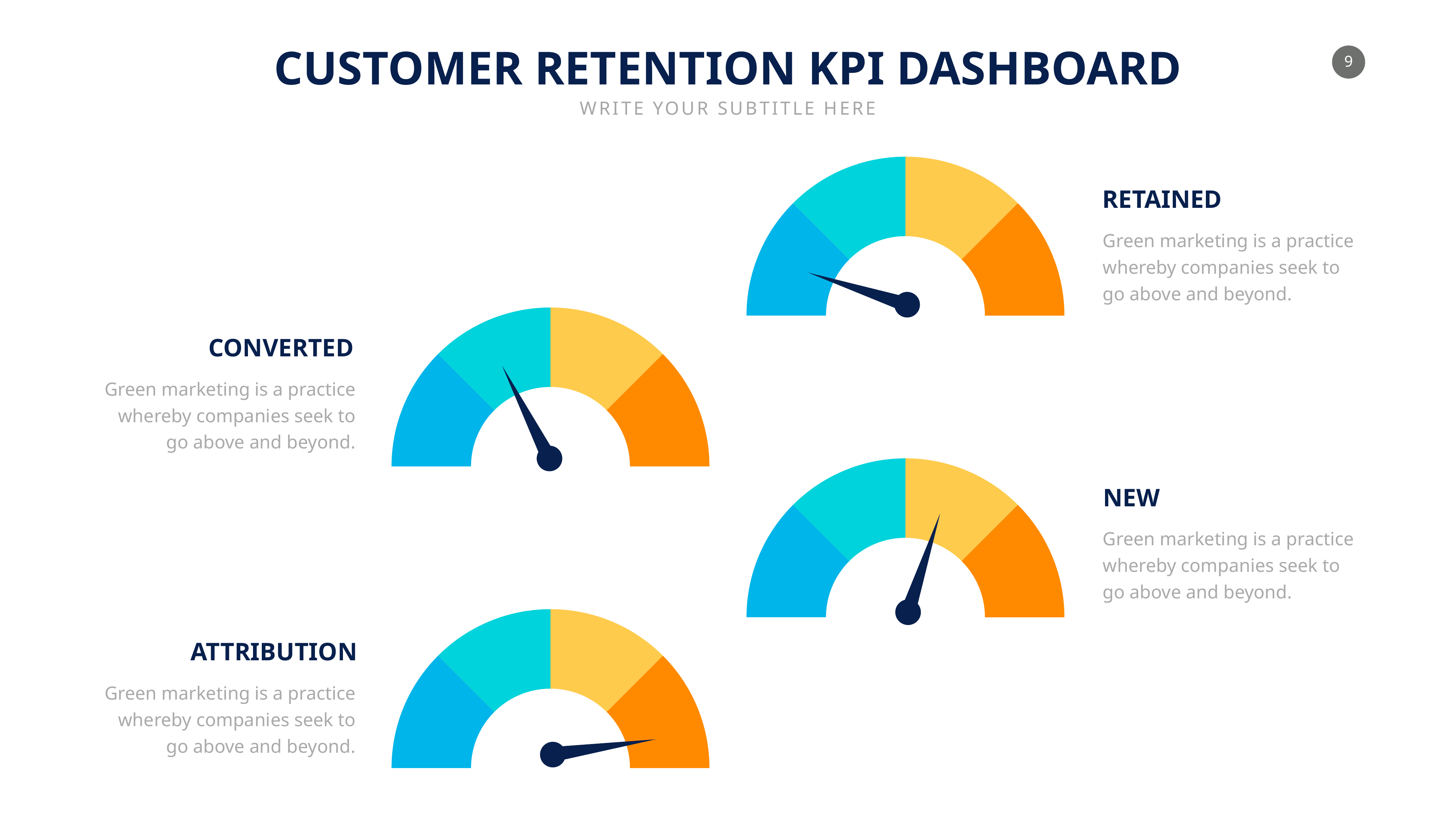
What is the title of the slide containing the gauges? CUSTOMER RETENTION KPI DASHBOARD On the NEW gauge, which coloured segment does the needle point into? Yellow (third segment from the left) Which gauge shows a higher reading, CONVERTED or NEW? NEW On the CONVERTED gauge, which coloured segment does the needle point into? Teal (second segment from the left) How many coloured segments does each gauge have? 4 How many gauge charts are shown on the slide? 4 What kind of chart is used for each KPI on the slide? Gauge chart Which gauge has its needle furthest to the left (lowest reading)? RETAINED Which gauge has its needle furthest to the right (highest reading)? ATTRIBUTION On the RETAINED gauge, which coloured segment does the needle point into? Blue (leftmost segment) On the ATTRIBUTION gauge, which coloured segment does the needle point into? Orange (rightmost segment) What colour is the rightmost segment of each gauge? Orange